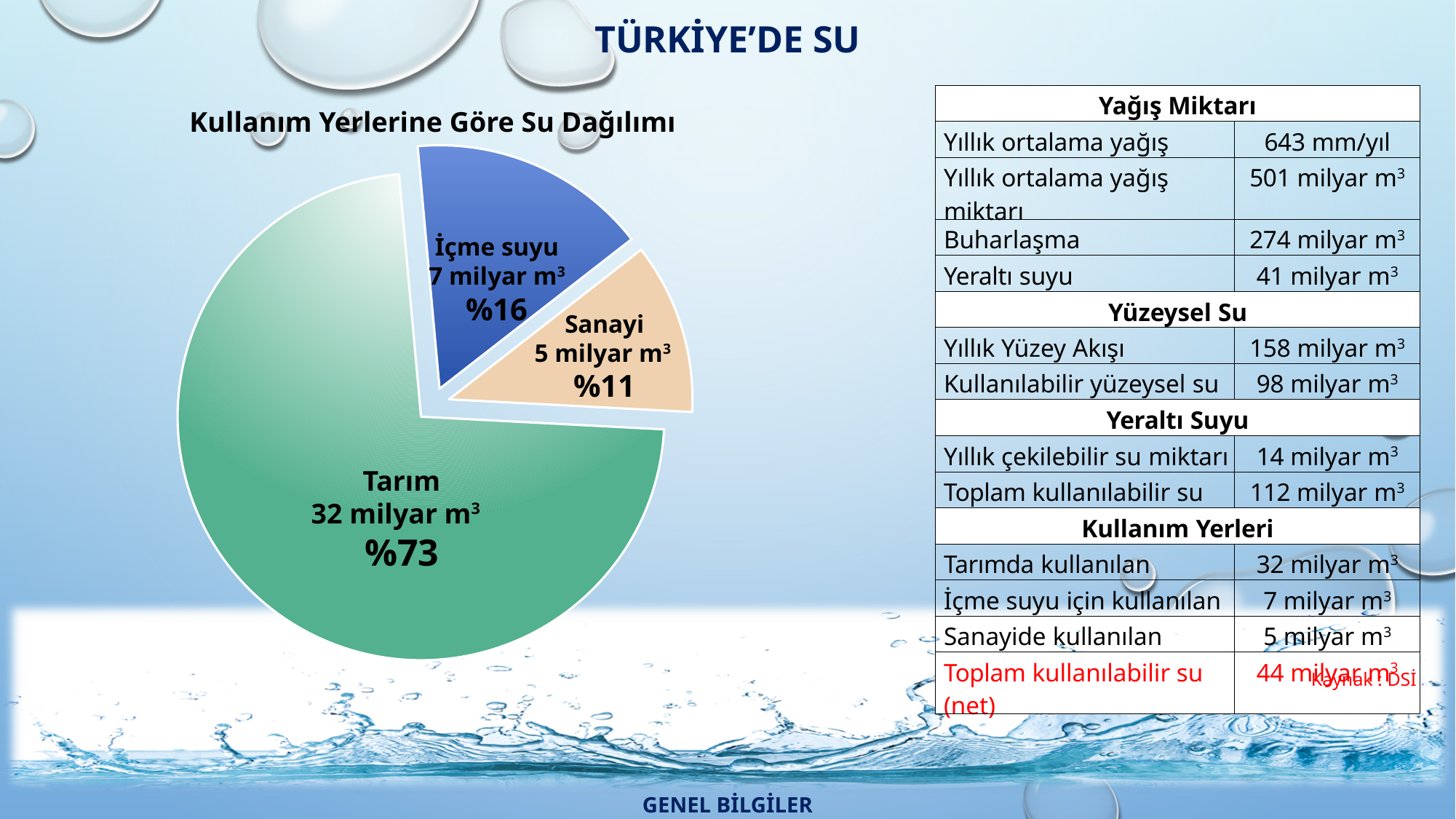
What share of the pie does Sanayi represent? %11 What is the difference in milyar m³ between Tarım and İçme suyu in the pie chart? 25 milyar m³ What share of the pie does Tarım represent? %73 What is the value shown for Tarım in the pie chart? 32 milyar m³ Which is larger in the pie chart, İçme suyu or Sanayi? İçme suyu What is the value shown for Sanayi in the pie chart? 5 milyar m³ What is the value shown for İçme suyu in the pie chart? 7 milyar m³ What is the title of the pie chart? Kullanım Yerlerine Göre Su Dağılımı What type of chart is shown on the slide? pie chart How many slices does the pie chart have? 3 Which category has the largest slice in the pie chart? Tarım Which category has the smallest slice in the pie chart? Sanayi